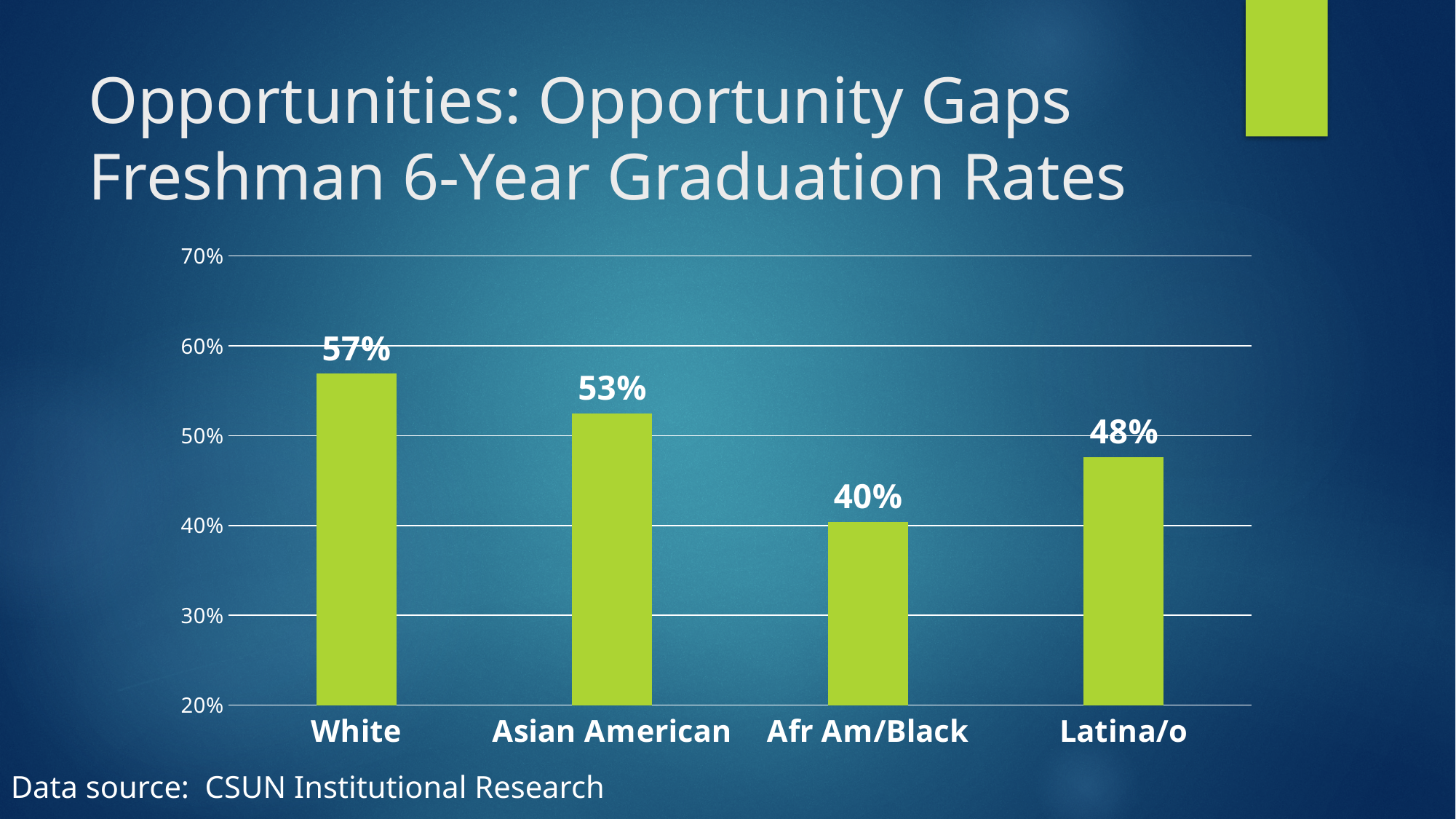
Which group has the highest graduation rate? White What kind of chart is shown on the slide? bar chart How many groups are shown in the chart? 4 Is the value for Latina/o greater or less than 50%? less Which is larger, the graduation rate for Latina/o students or for Afr Am/Black students? Latina/o What is the freshman 6-year graduation rate for White students? 57% What is the freshman 6-year graduation rate for Asian American students? 53% What is the difference between the graduation rates for White and Afr Am/Black students? 17% What is the difference between the graduation rates for Asian American and Latina/o students? 5% What is the freshman 6-year graduation rate for Afr Am/Black students? 40% Which group has the lowest graduation rate? Afr Am/Black What is the freshman 6-year graduation rate for Latina/o students? 48%